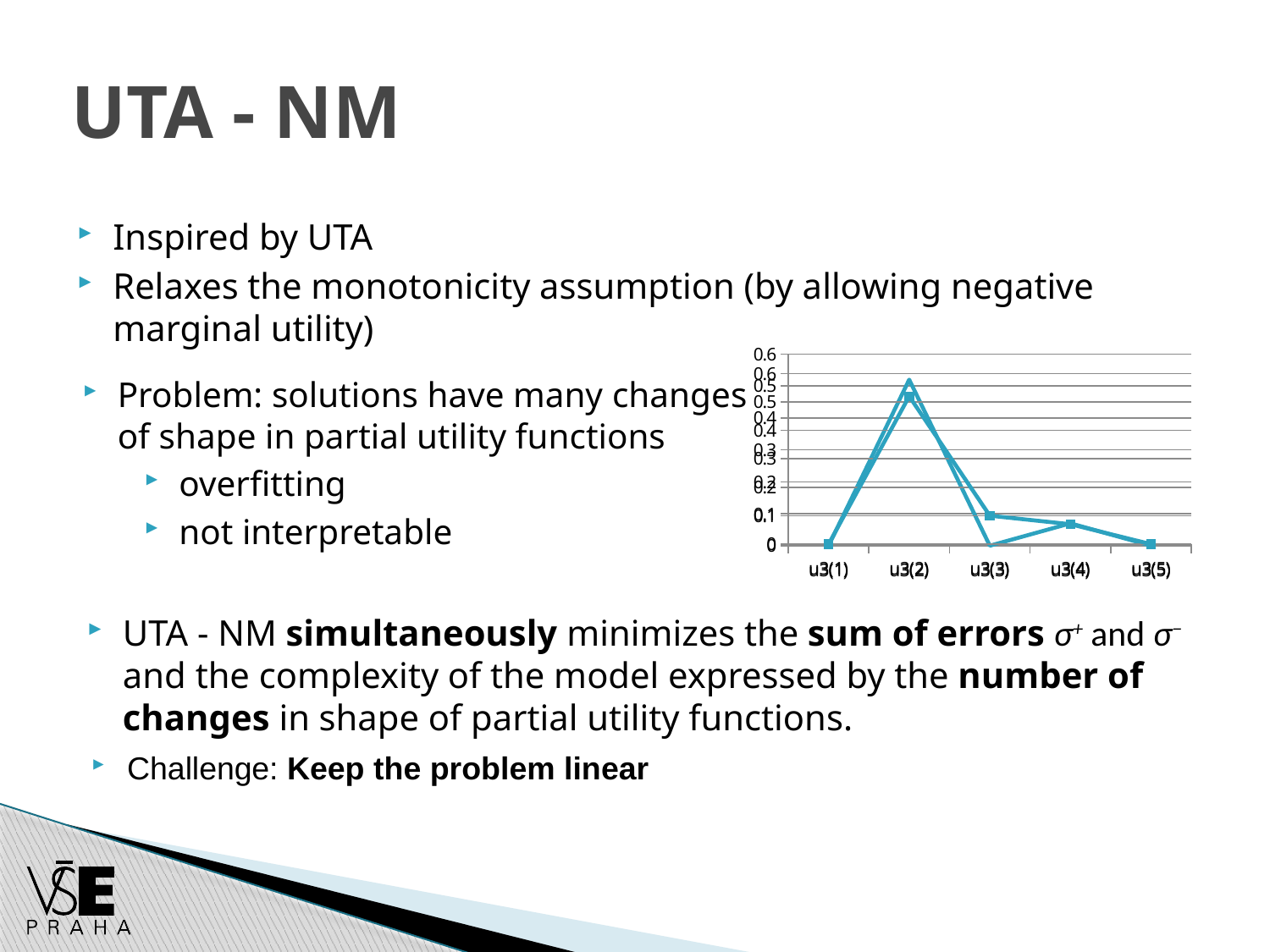
What is the value plotted for u3(1) in the chart? 0 Is the value for u3(3) greater or less than 0.3? less What is the highest value shown on the y axis of the chart? 0.6 Is the value for u3(2) greater or less than 0.4? greater What is the label of the first category on the x axis of the chart? u3(1) Is the value for u3(4) greater or less than 0.2? less What is the value plotted for u3(5) in the chart? 0 How many categories are shown on the x axis of the chart? 5 What kind of chart is shown on the slide? line chart Which has the larger value in the chart, u3(2) or u3(3)? u3(2) Which category on the x axis has the highest value in the chart? u3(2)